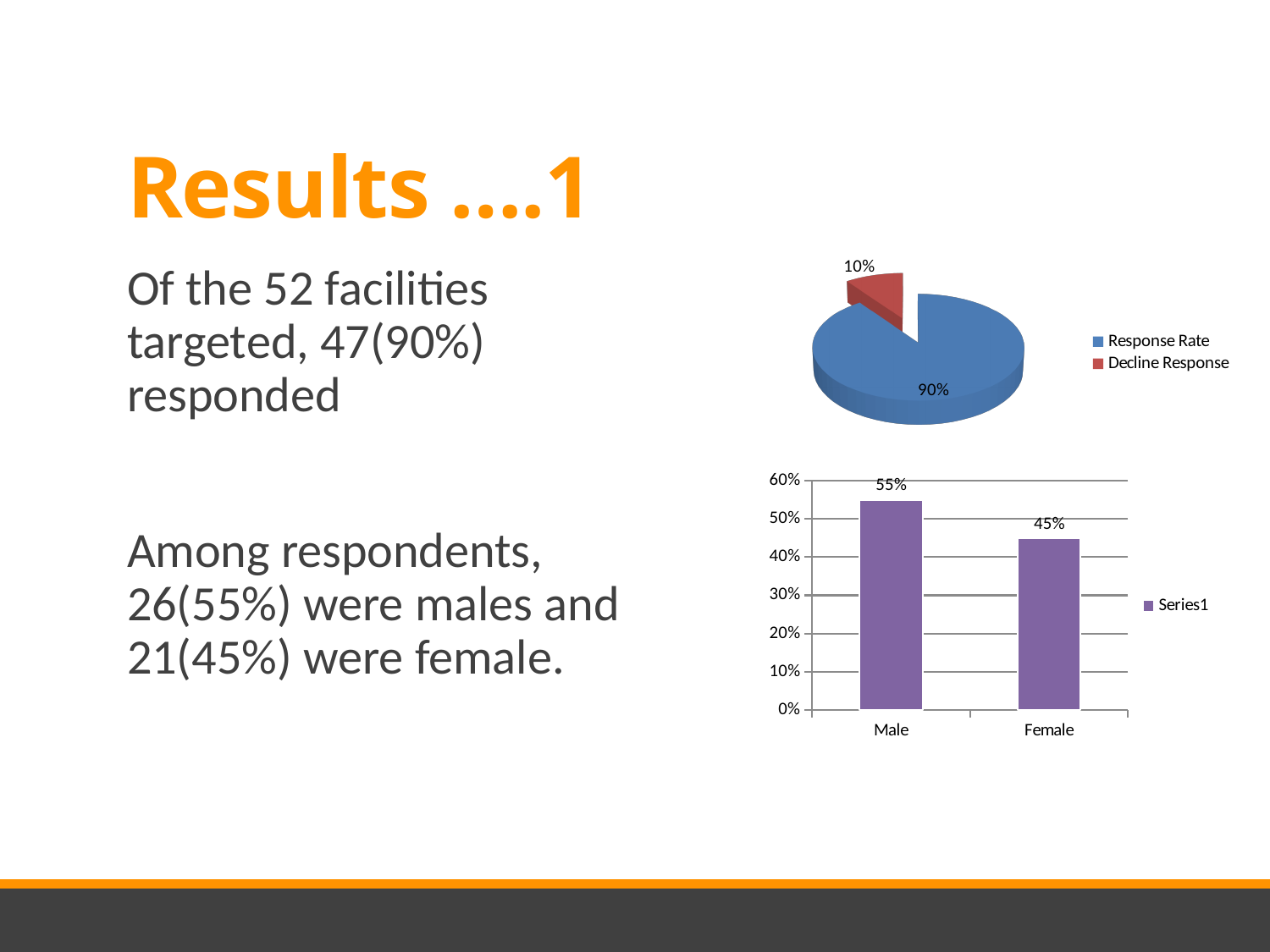
What kind of chart is the chart at the top right of the slide? pie chart In the pie chart at the top right, which slice is the largest? Response Rate In the bar chart at the bottom right, what is the value for Male? 55% In the pie chart at the top right, what share does Response Rate have? 90% In the bar chart at the bottom right, how many categories are shown on the x axis? 2 In the bar chart at the bottom right, what series name does the legend list? Series1 In the bar chart at the bottom right, what is the difference between the Male and Female values? 10% In the pie chart at the top right, what is the difference between the Response Rate and Decline Response shares? 80% In the bar chart at the bottom right, which category has the higher value, Male or Female? Male In the bar chart at the bottom right, what is the value for Female? 45% In the pie chart at the top right, what share does Decline Response have? 10% In the pie chart at the top right, how many slices are there? 2